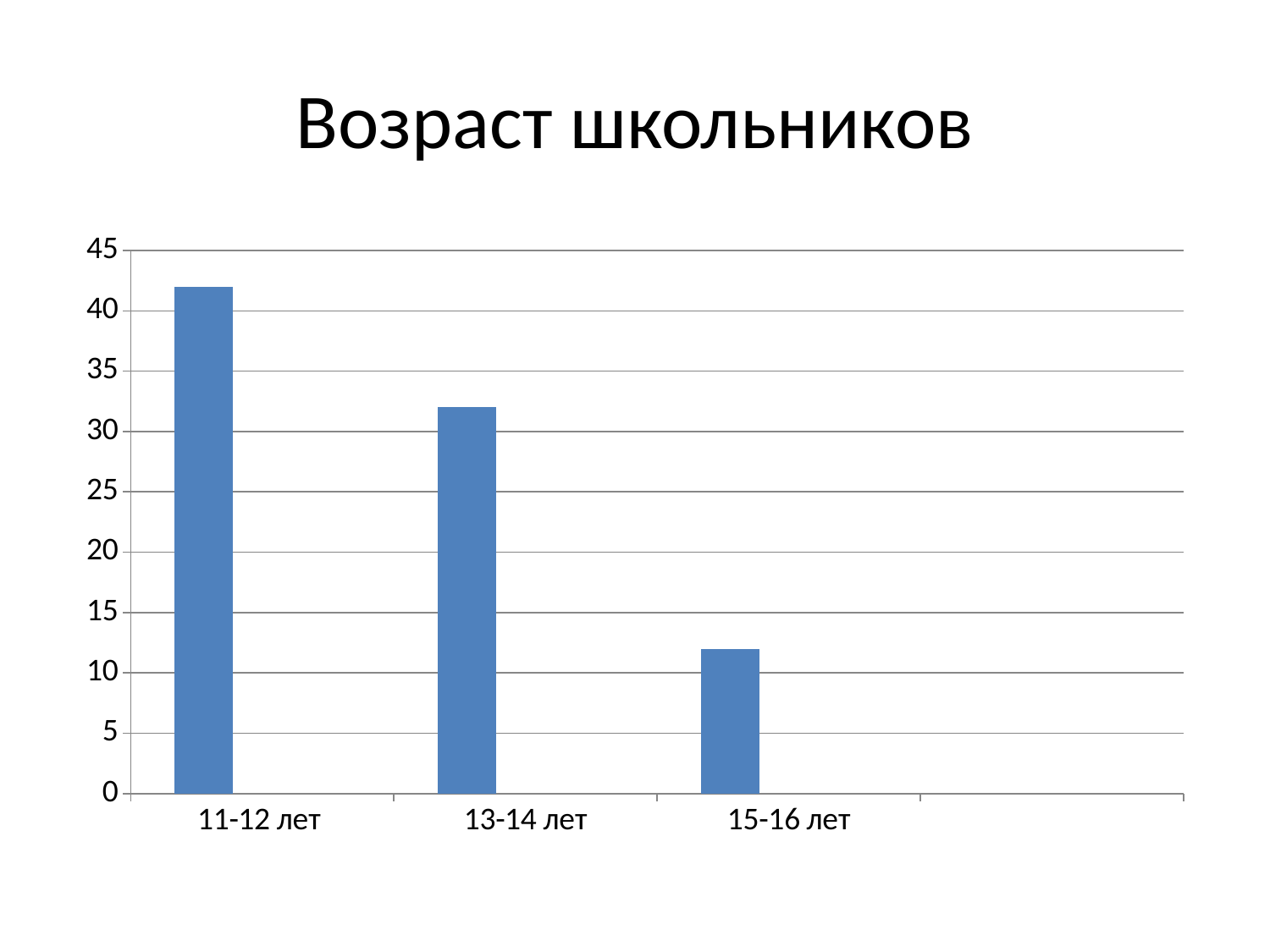
Which age category has the highest bar? 11-12 лет What kind of chart is shown on the slide? bar chart Is the value for 11-12 лет greater or less than 40? greater Which is larger, the value for 13-14 лет or the value for 15-16 лет? 13-14 лет Is the value for 13-14 лет greater or less than 30? greater What is the highest value shown on the vertical axis? 45 Is the value for 13-14 лет greater or less than 35? less What is the title of the chart? Возраст школьников Do the values rise or fall from left to right along the x axis? fall Which age category has the lowest bar? 15-16 лет How many age categories are shown on the x axis? 3